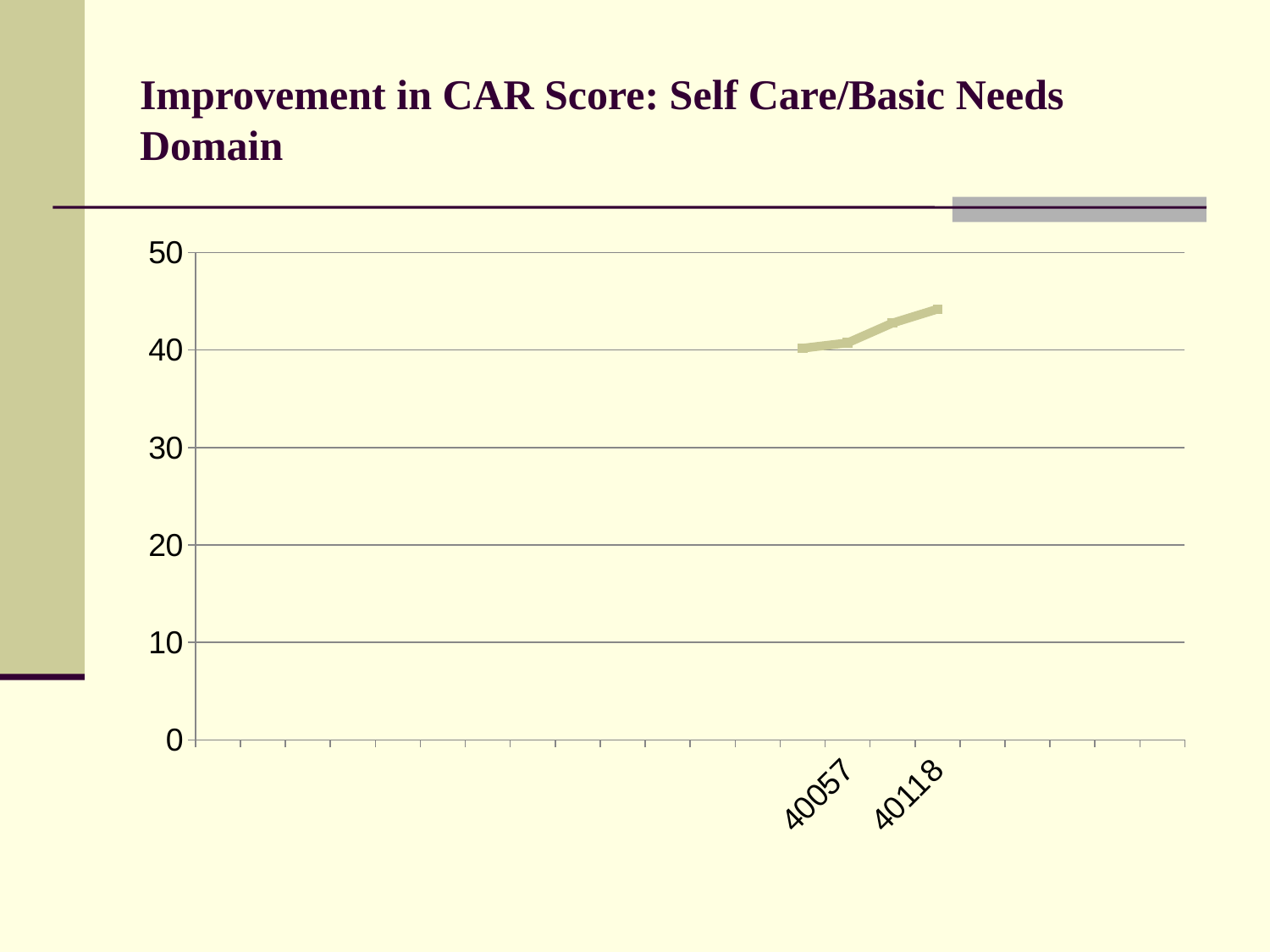
What kind of chart is shown on the slide? line chart Which has the larger value, 40057 or 40118? 40118 What is the highest value shown on the vertical axis? 50 What is the title of the slide containing the chart? Improvement in CAR Score: Self Care/Basic Needs Domain Is the value at 40057 greater or less than 30? greater Do the plotted values rise or fall from 40057 to 40118? rise Is the value at 40057 greater or less than 50? less Is the value at 40118 greater or less than 50? less